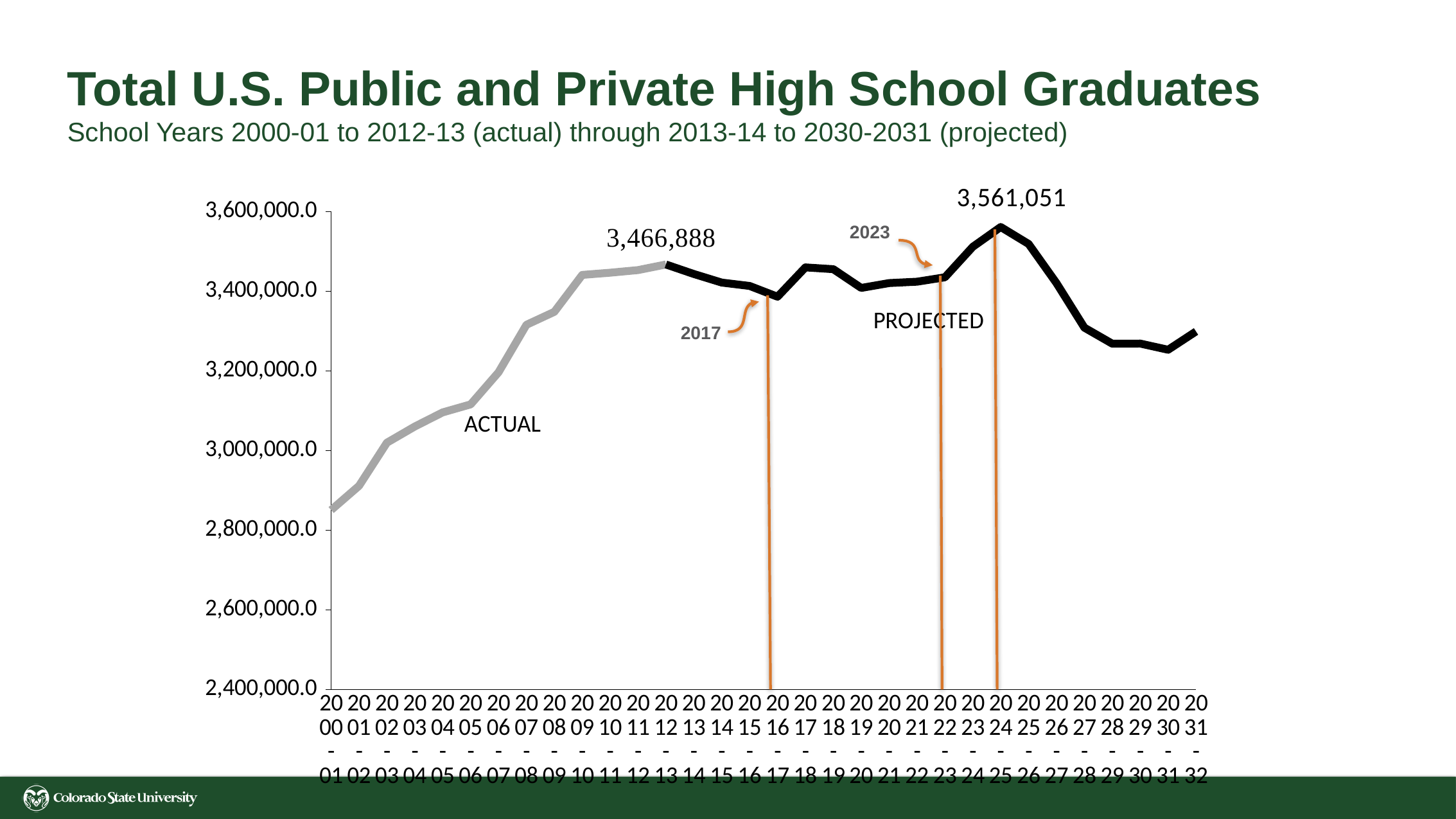
Which school year has the highest number of graduates on the chart? 2024-25 What kind of chart is shown on the slide? line chart Which school year has the lowest number of graduates on the chart? 2000-01 What two labels distinguish the grey and black segments of the line? ACTUAL and PROJECTED What is the difference between the labelled peak value 3,561,051 and the labelled 2012-13 value 3,466,888? 94,163 Which is larger, the value for 2012-13 or the value for 2024-25? 2024-25 Is the value for school year 2000-01 greater or less than 3,000,000? less Is the value for school year 2031-32 greater or less than 3,400,000? less Do the values rise or fall from school year 2000-01 to 2012-13? rise What is the value labelled at the peak of the projected data (school year 2024-25)? 3,561,051 What is the value labelled at the end of the actual data (school year 2012-13)? 3,466,888 How many school years are plotted along the x axis? 32